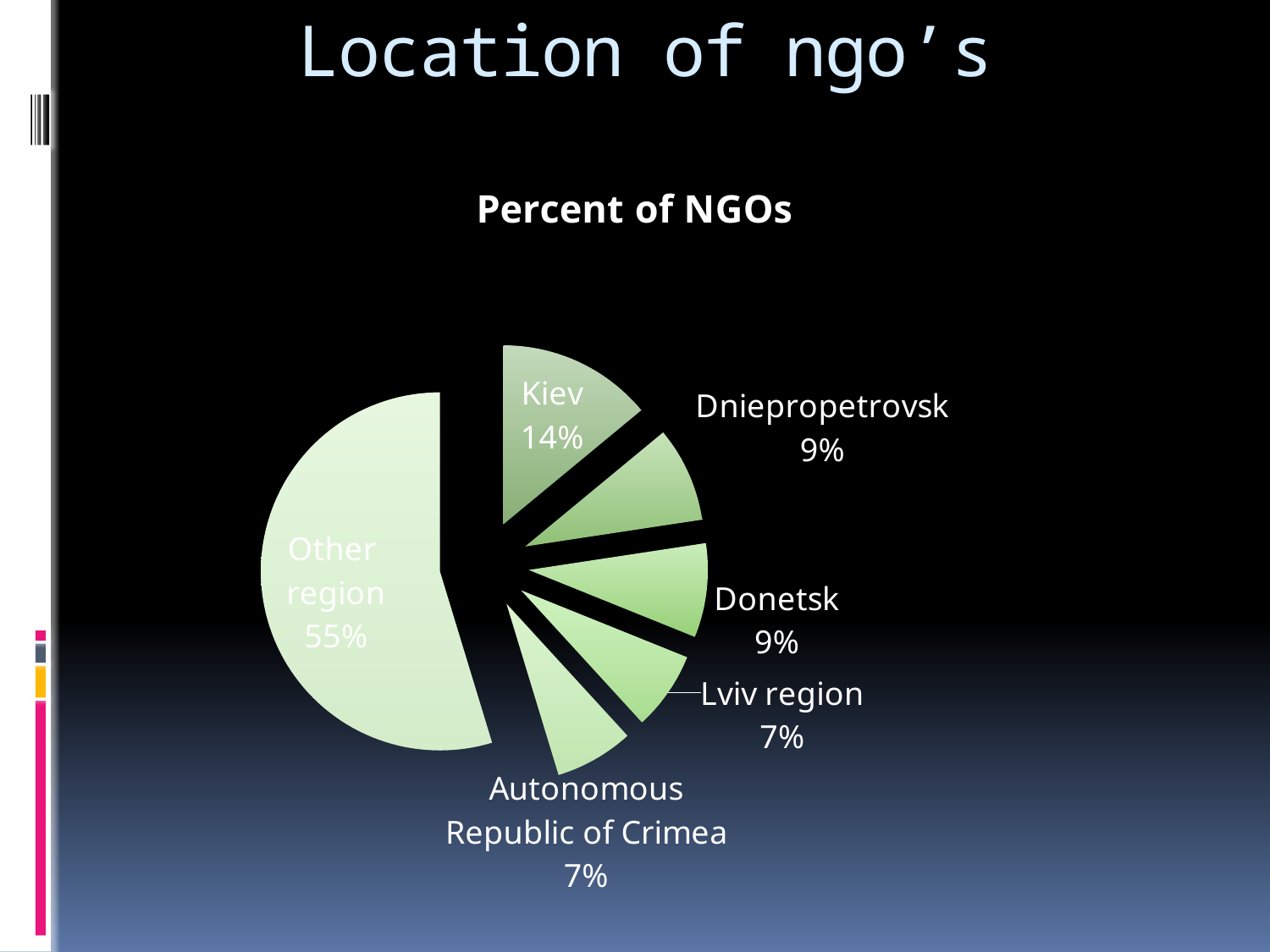
What percentage of NGOs are located in Kiev? 14% What type of chart is shown on the slide? Pie chart How many slices does the pie chart have? 6 What is the value for Autonomous Republic of Crimea? 7% What share of the pie does Other region represent? 55% What is the chart's title? Percent of NGOs What is the difference between the Kiev share and the Dniepropetrovsk share? 5% Which category has the largest slice of the pie? Other region Which is larger, the share for Kiev or the share for Donetsk? Kiev What is the difference between the Other region share and the Kiev share? 41% What is the value for Donetsk? 9% What is the value for Lviv region? 7%